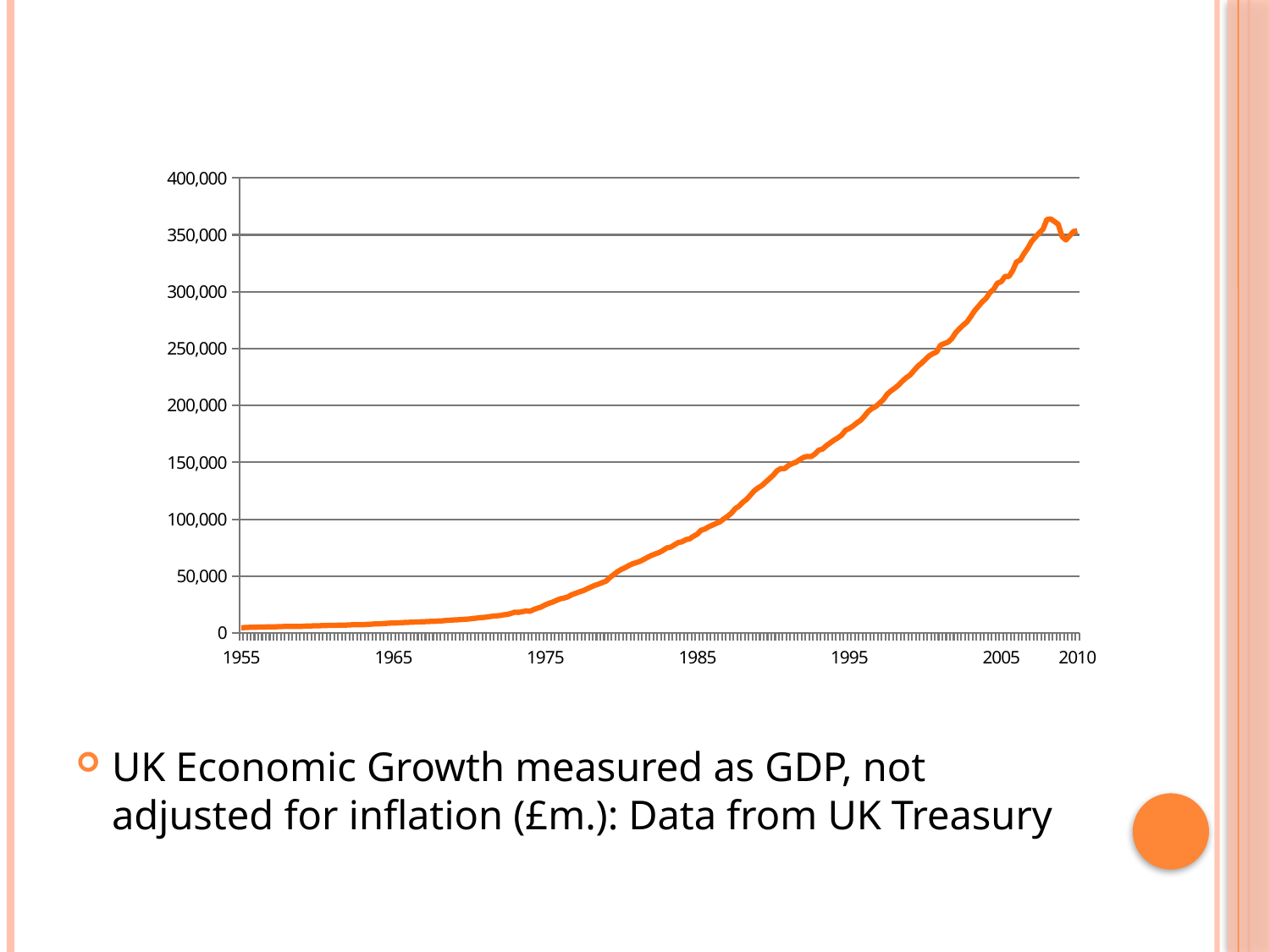
Do the values generally rise or fall from 1955 to 2005? rise Is the value for 1985 greater or less than 50,000? greater Is the highest point on the line greater or less than 400,000? less Is the value for 1995 greater or less than 150,000? greater What kind of chart is shown on the slide? line chart Which year has the larger value, 1985 or 1995? 1995 What is the highest value shown on the vertical axis? 400,000 What is the first year labelled on the horizontal axis? 1955